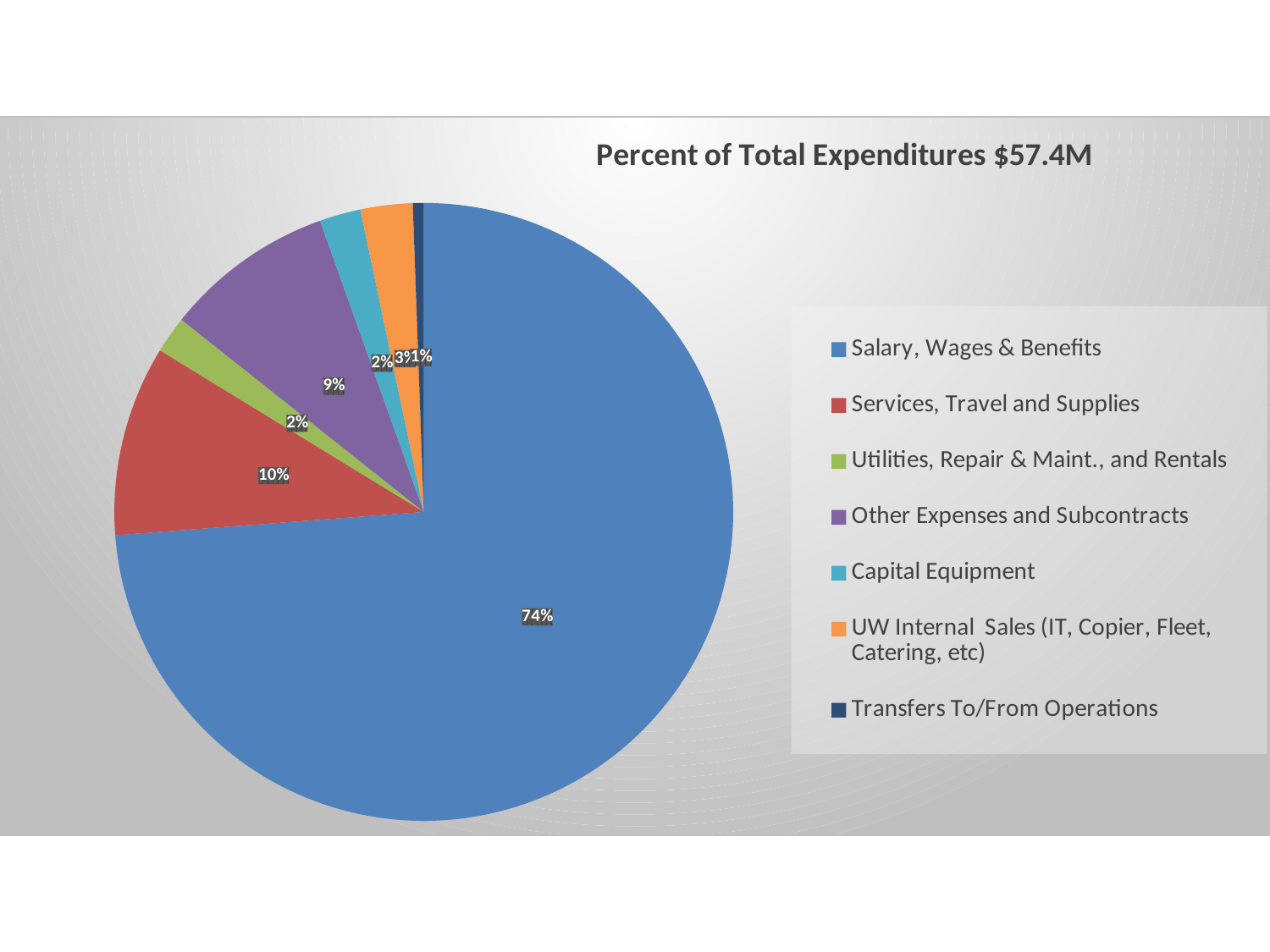
Which category has the smallest share of total expenditures? Transfers To/From Operations What type of chart is shown on the slide? pie chart What percentage of total expenditures is Services, Travel and Supplies? 10% Which category has the largest share of total expenditures? Salary, Wages & Benefits How many categories does the legend list? 7 What is the difference in percentage points between Salary, Wages & Benefits and Services, Travel and Supplies? 64 What is the title of the chart? Percent of Total Expenditures $57.4M What percentage of total expenditures is Salary, Wages & Benefits? 74% What percentage of total expenditures is Capital Equipment? 2% What percentage of total expenditures is Utilities, Repair & Maint., and Rentals? 2% Which is larger, the share for Services, Travel and Supplies or the share for Other Expenses and Subcontracts? Services, Travel and Supplies What percentage of total expenditures is Other Expenses and Subcontracts? 9%